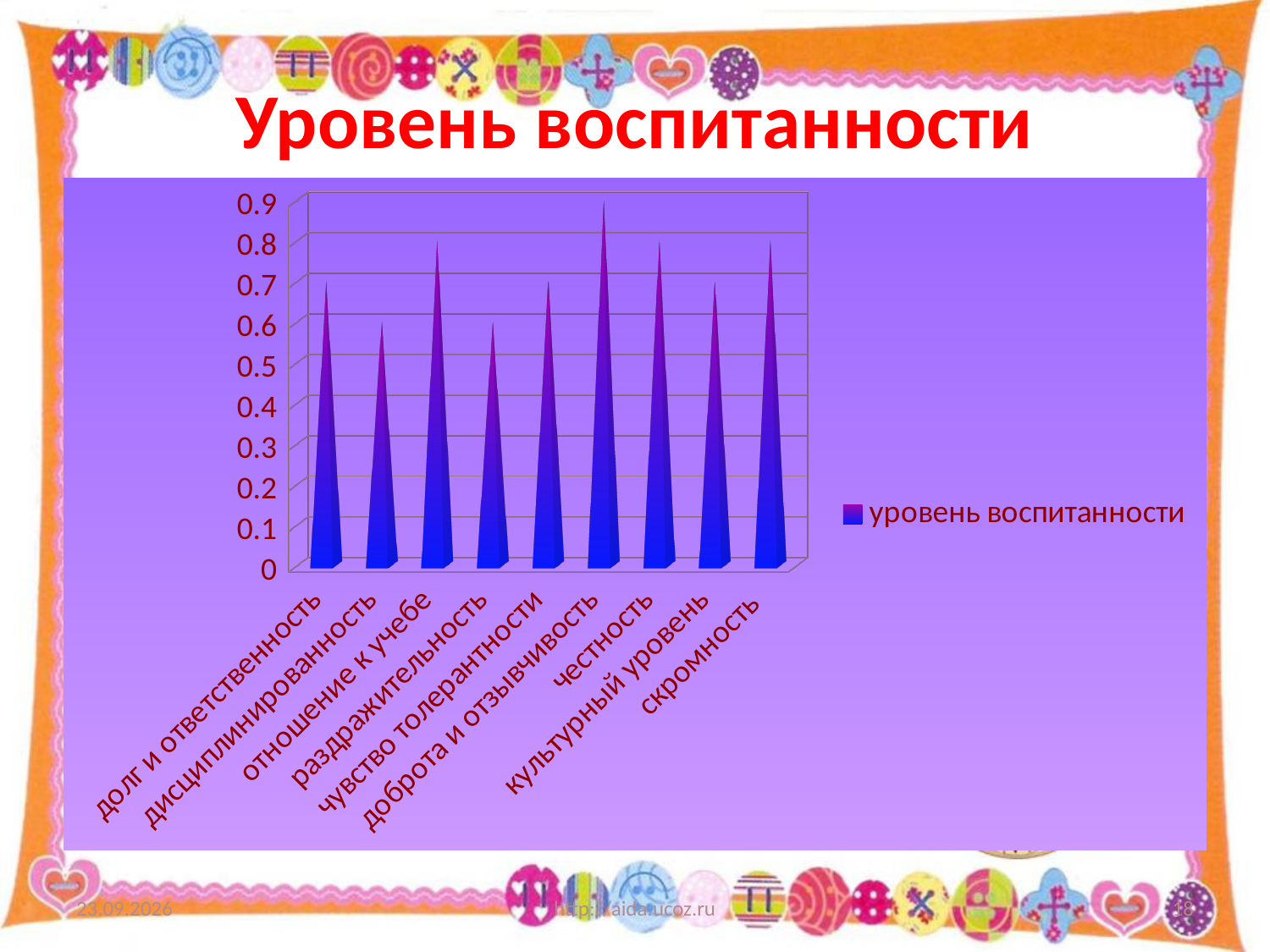
Is the value for раздражительность greater or less than 0.5? greater How many series does the legend list? 1 What is the legend entry of the chart? уровень воспитанности How many categories are plotted on the chart? 9 Is the value for отношение к учебе greater or less than 0.7? greater Which is larger, the value for честность or the value for раздражительность? честность What is the title of the slide with the chart? Уровень воспитанности Which category has the highest value? доброта и отзывчивость Which is larger, the value for доброта и отзывчивость or the value for дисциплинированность? доброта и отзывчивость What kind of chart is shown on the slide? bar chart Is the value for дисциплинированность greater or less than 0.7? less